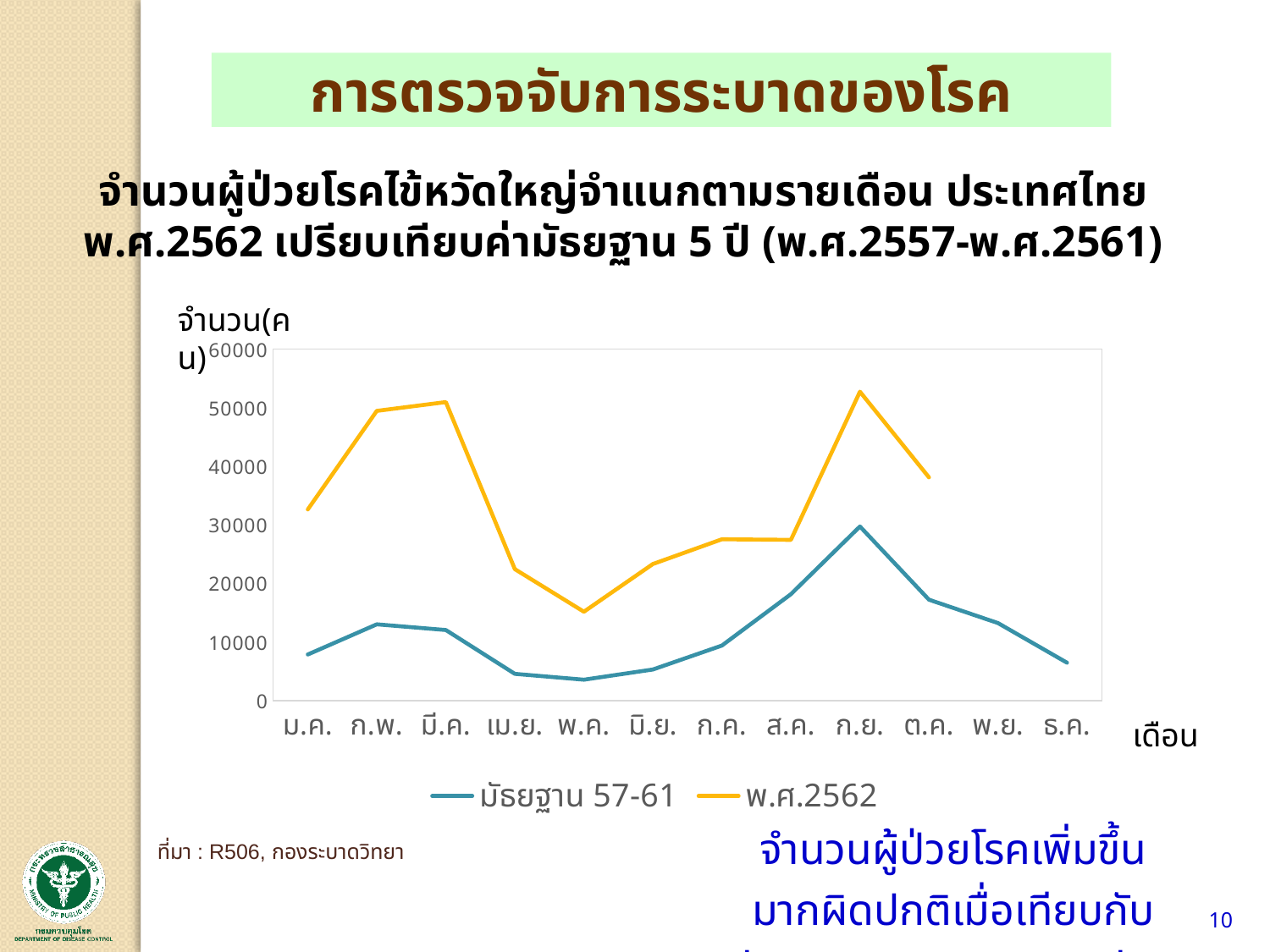
How many series does the legend list? 2 Is the value for พ.ศ.2562 in ม.ค. greater or less than 30000? greater In ก.พ., which series has the larger value, มัธยฐาน 57-61 or พ.ศ.2562? พ.ศ.2562 Is the value for พ.ศ.2562 in ก.ย. greater or less than 50000? greater What are the two series named in the legend? มัธยฐาน 57-61 and พ.ศ.2562 In which month does the พ.ศ.2562 series reach its lowest value? พ.ค. Which colour is used for the พ.ศ.2562 series? yellow What kind of chart is shown on the slide? line chart In which month does the มัธยฐาน 57-61 series reach its highest value? ก.ย. How many months are shown on the x axis? 12 Does the มัธยฐาน 57-61 series rise or fall from ก.ย. to ธ.ค.? fall Is the value for มัธยฐาน 57-61 in ธ.ค. greater or less than 10000? less